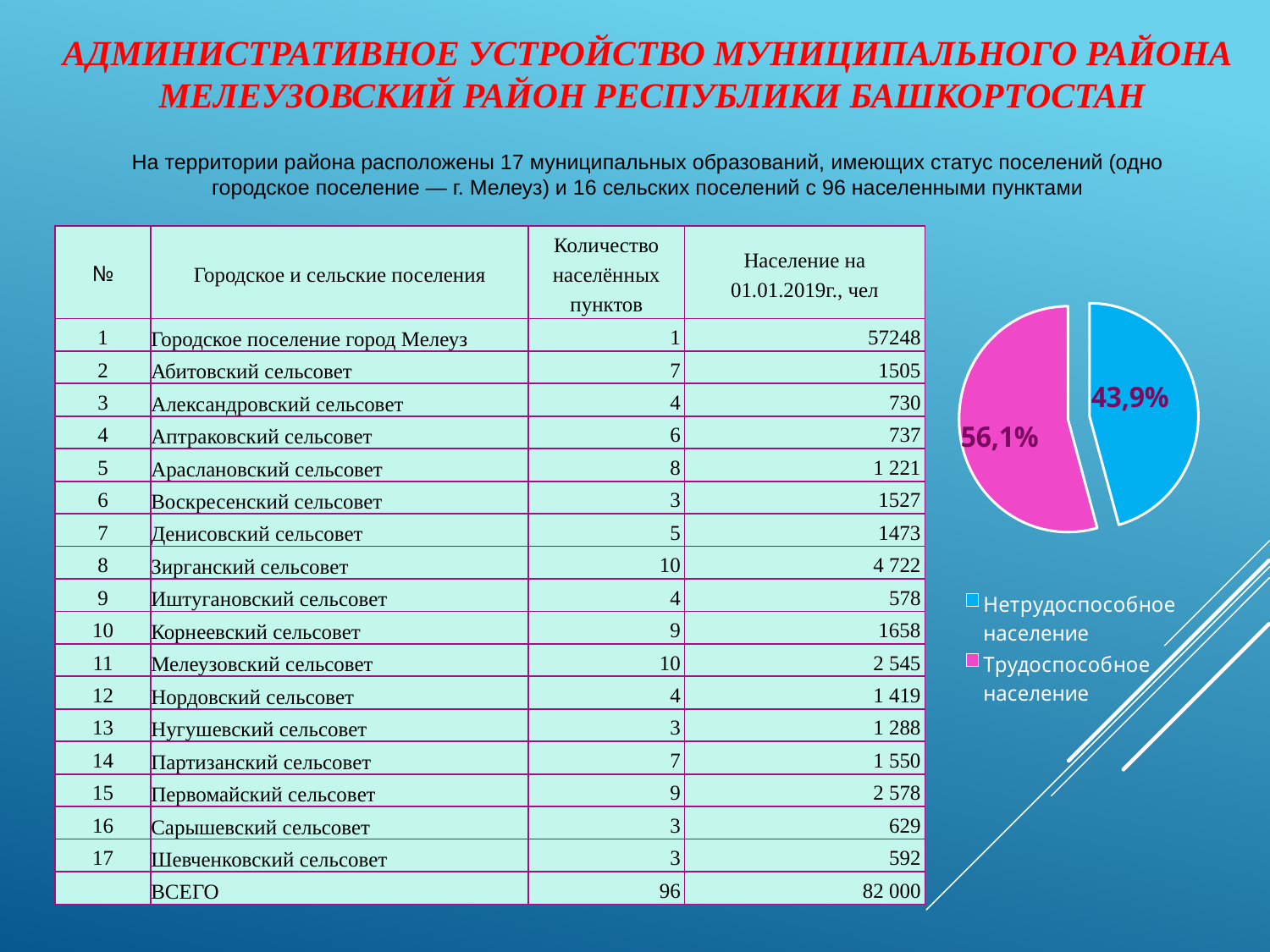
What kind of chart is shown on the right side of the slide? pie chart In the pie chart, which is larger: Трудоспособное население or Нетрудоспособное население? Трудоспособное население Which slice of the pie chart is the smallest? Нетрудоспособное население In the pie chart, what share is labelled for Нетрудоспособное население? 43,9% What colour is the Нетрудоспособное население slice in the pie chart? blue What is the difference in percentage points between the two slices of the pie chart? 12,2 What colour is the Трудоспособное население slice in the pie chart? pink In the pie chart, what share is labelled for Трудоспособное население? 56,1% Which slice of the pie chart is the largest? Трудоспособное население How many slices does the pie chart have? 2 How many entries does the pie chart legend list? 2